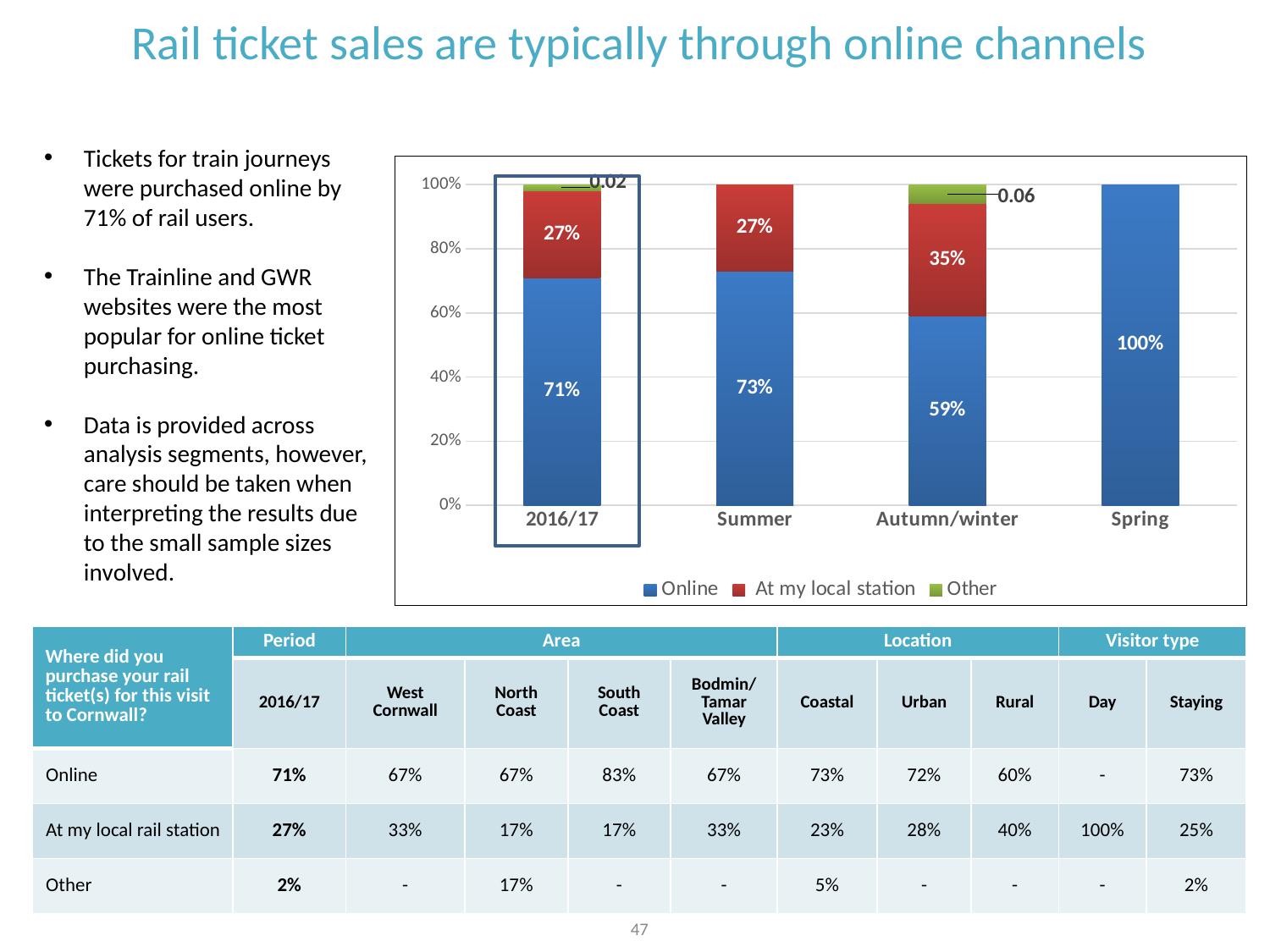
Which category has the lowest Online value? Autumn/winter What kind of chart is shown on the slide? stacked bar chart What is the difference between the Online values for Summer and Autumn/winter? 14% What is the Online value for Spring? 100% How many categories are shown on the x axis of the chart? 4 What is the Online value for Summer? 73% What is the 'Other' data label shown for Autumn/winter? 0.06 What is the 'At my local station' value for Autumn/winter? 35% Which category has the highest Online value? Spring What is the Online value for 2016/17? 71% How many series does the chart legend list? 3 Which series is shown in blue in the chart? Online